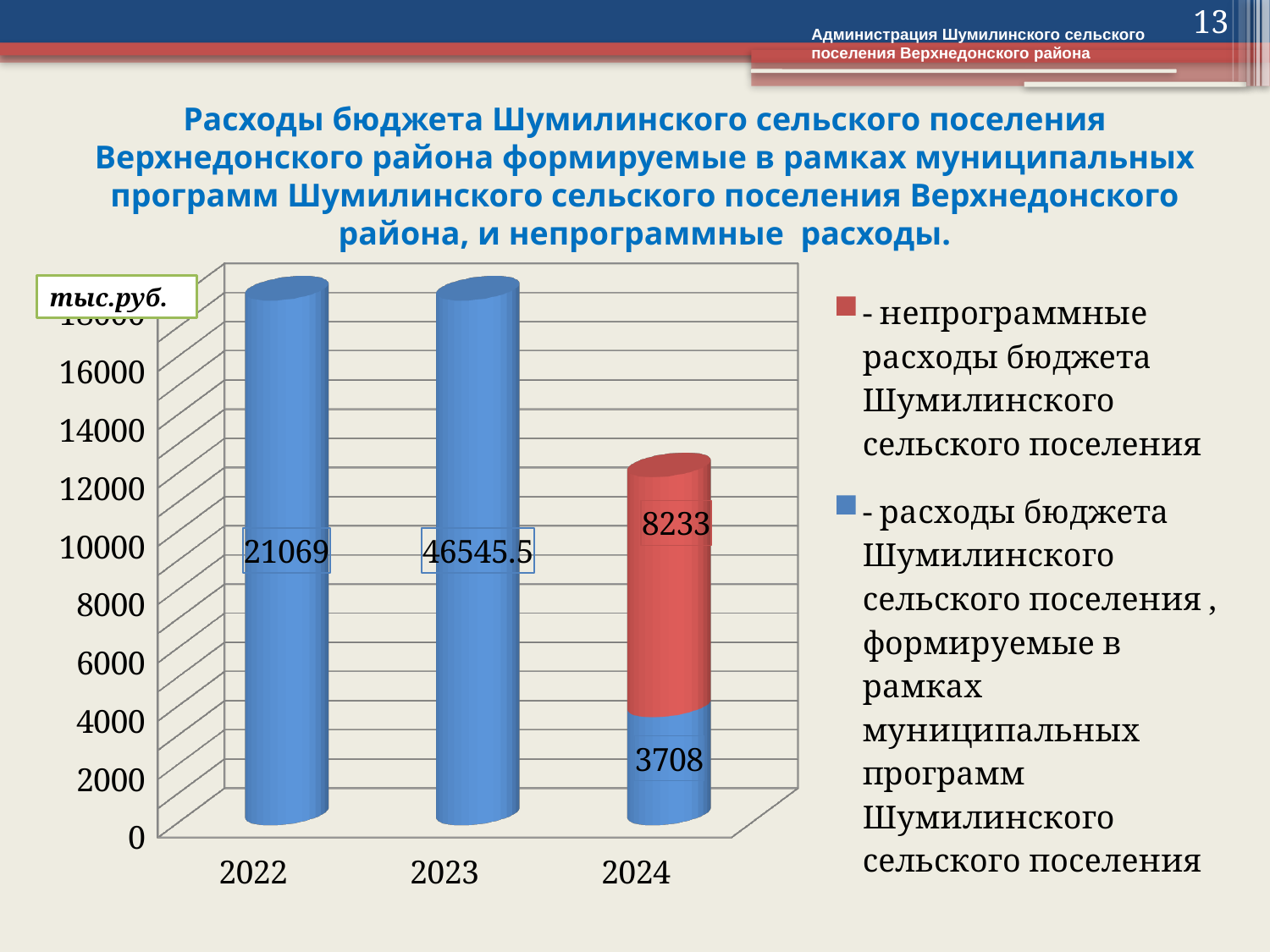
What kind of chart is shown on the slide? Bar chart (stacked) What is the value of the budget expenses formed within municipal programs (blue series) for 2023? 46545.5 In 2024, which is larger: the non-program expenses or the expenses within municipal programs? Non-program expenses (8233) What is the difference between the program expenses in 2023 and in 2022? 25476.5 What is the difference between the non-program expenses and the program expenses in 2024? 4525 How many series does the legend list? 2 What is the value of the budget expenses formed within municipal programs (blue series) for 2022? 21069 Which year has the highest value for expenses within municipal programs? 2023 What is the value of the budget expenses formed within municipal programs (blue series) for 2024? 3708 What is the total of the stacked bar for 2024? 11941 How many years (categories) are shown on the x axis? 3 What is the value of the non-program budget expenses (red series) for 2024? 8233